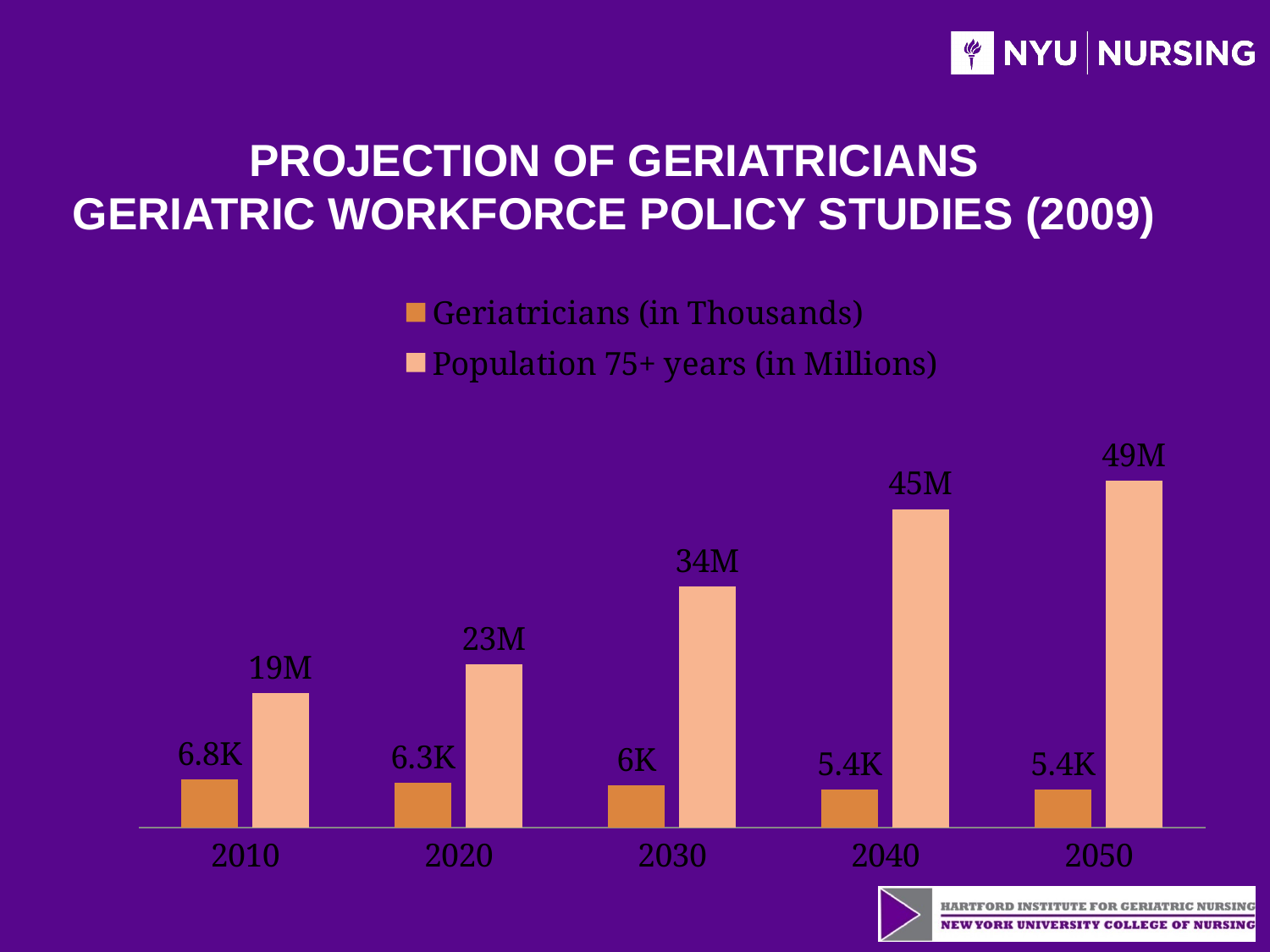
What is the value for Population 75+ years (in Millions) in 2030? 34M Which is larger, the Population 75+ years value for 2020 or for 2040? 2040 What is the value for Population 75+ years (in Millions) in 2050? 49M How many years are shown on the x axis? 5 Which year has the lowest value for Population 75+ years (in Millions)? 2010 What kind of chart is shown on the slide? Bar chart Which year has the highest value for Geriatricians (in Thousands)? 2010 How many series does the legend list? 2 What is the difference between the Geriatricians values for 2010 and 2030? 0.8K What is the value for Geriatricians (in Thousands) in 2010? 6.8K Which year has the highest value for Population 75+ years (in Millions)? 2050 What is the difference between the Population 75+ years values for 2050 and 2010? 30M